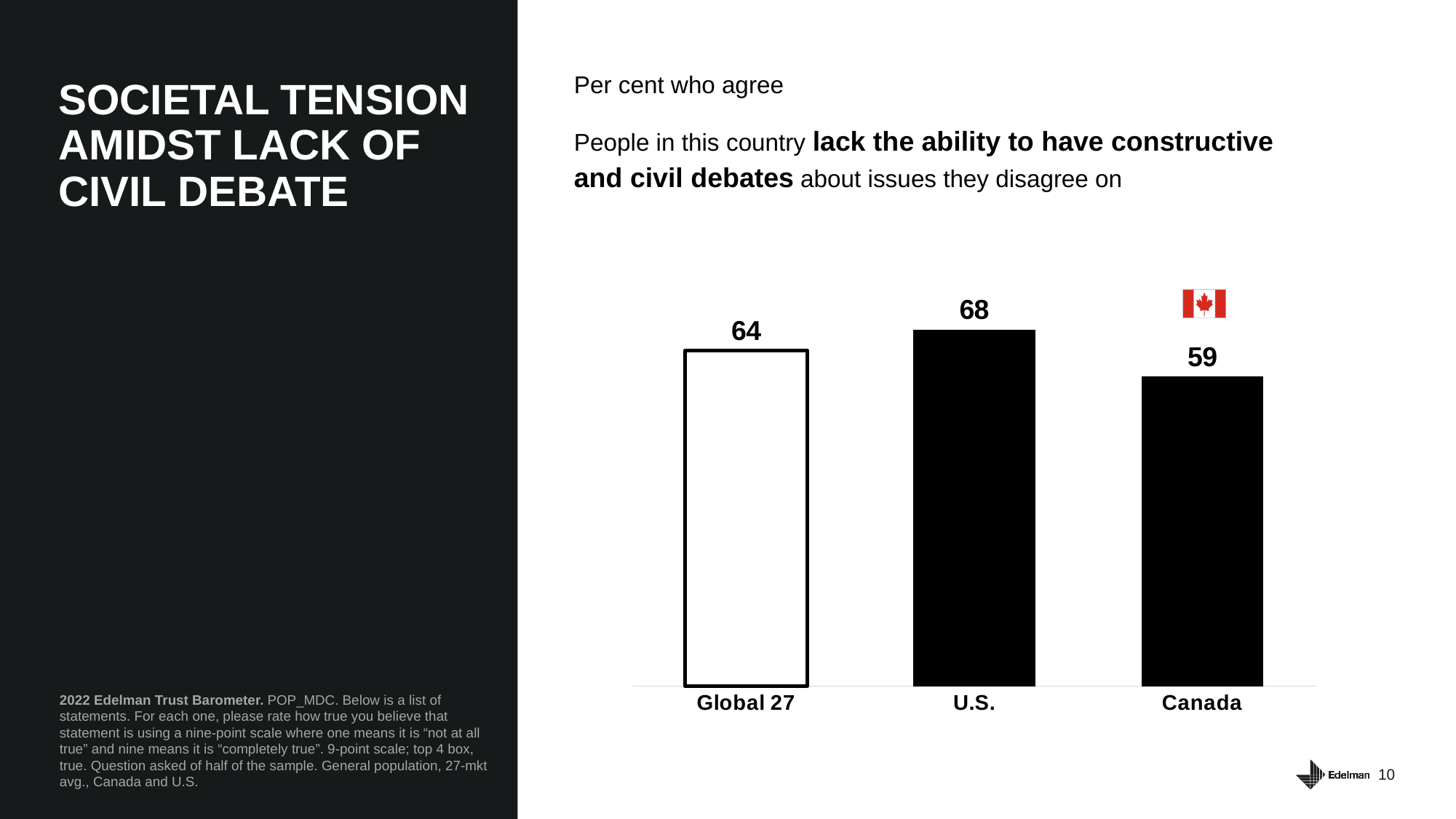
Which category has the lowest value? Canada What kind of chart is shown on the slide? Bar chart What is the value for Global 27? 64 What is the value for Canada? 59 How many categories are shown in the chart? 3 Which category has the highest value? U.S. What is the difference between the U.S. and Canada values? 9 What is the value for the U.S.? 68 Which category has a flag icon above its bar? Canada Which is larger, the value for Global 27 or the value for the U.S.? U.S. Which bar is drawn as an outline rather than filled in black? Global 27 What is the difference between the Global 27 and Canada values? 5